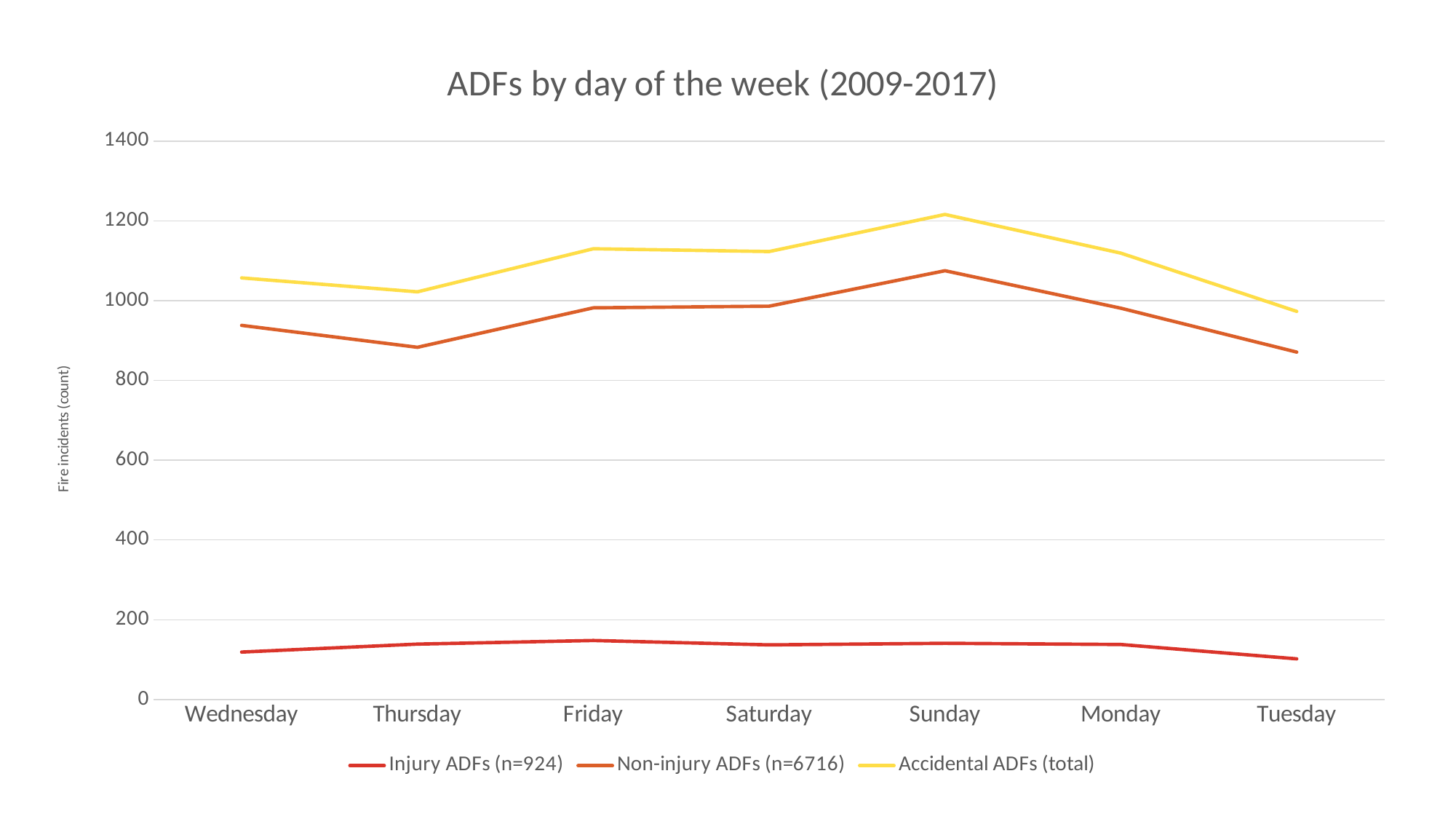
On which day is the Accidental ADFs (total) line highest? Sunday Is the value for Non-injury ADFs (n=6716) on Thursday greater or less than 900? less How many days of the week are plotted along the x axis? 7 On which day is the Injury ADFs (n=924) line lowest? Tuesday Is the value for Accidental ADFs (total) on Sunday greater or less than 1200? greater On which day is the Non-injury ADFs (n=6716) line highest? Sunday Which is larger for Non-injury ADFs (n=6716): the value on Wednesday or the value on Thursday? Wednesday How many series does the legend list? 3 On which day is the Accidental ADFs (total) line lowest? Tuesday Is the value for Injury ADFs (n=924) on Wednesday greater or less than 200? less What kind of chart is shown on the slide? line chart What is the title of the vertical axis? Fire incidents (count)